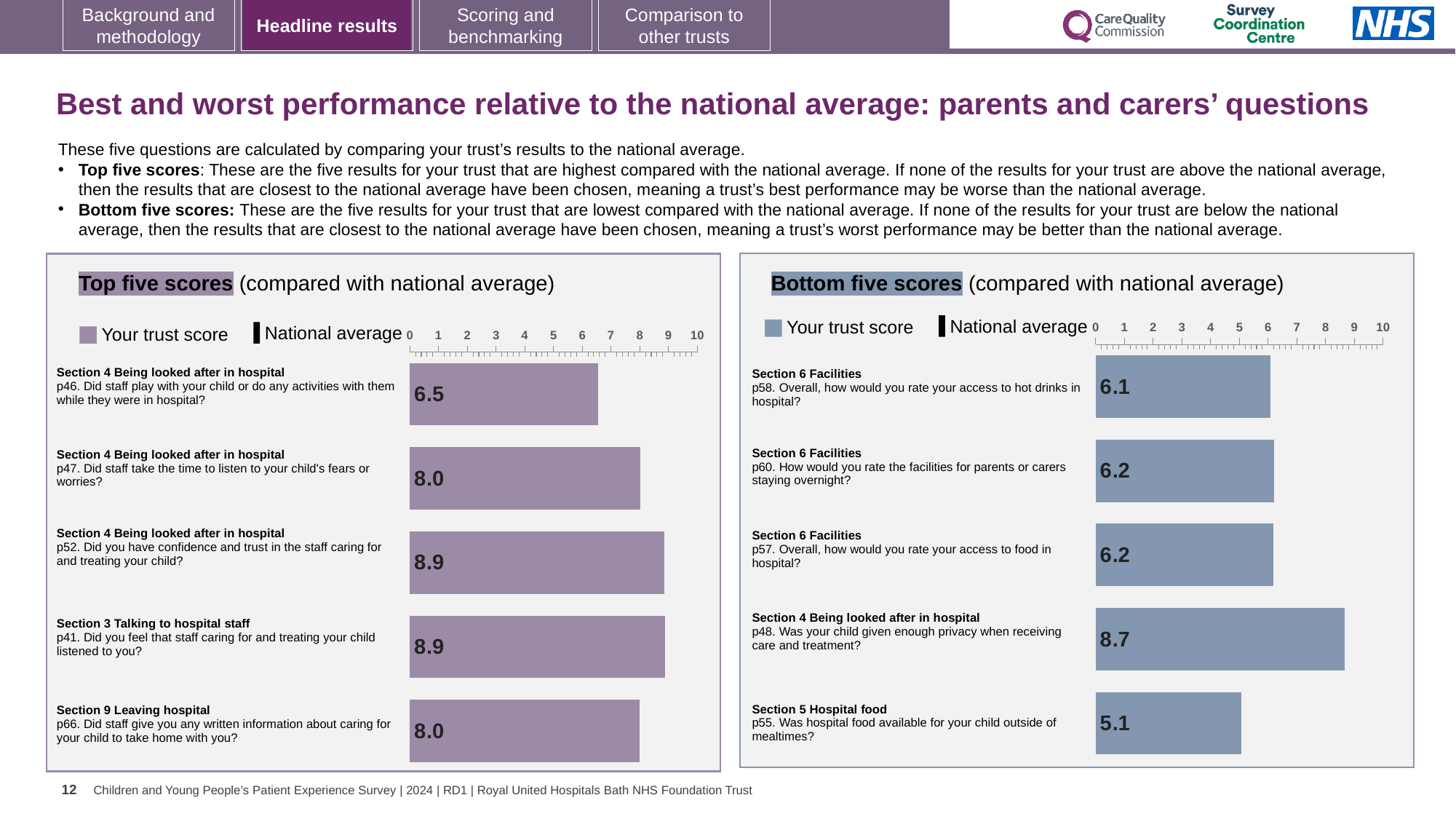
In the Bottom five scores chart, what is the trust score for p48 (Was your child given enough privacy when receiving care and treatment)? 8.7 In the Bottom five scores chart, which question has the lowest trust score? p55. Was hospital food available for your child outside of mealtimes? How many bars are shown in the Bottom five scores chart? 5 In the Top five scores chart, what is the difference between the trust score for p52 and the trust score for p46? 2.4 Which is larger: the trust score for p47 in the Top five scores chart or the trust score for p58 in the Bottom five scores chart? p47 in the Top five scores chart In the Bottom five scores chart, what is the difference between the trust score for p48 and the trust score for p55? 3.6 In the Top five scores chart, which question has the lowest trust score? p46. Did staff play with your child or do any activities with them while they were in hospital? In the Top five scores chart, what is the trust score for p52 (Did you have confidence and trust in the staff caring for and treating your child)? 8.9 In the Top five scores chart, what is the trust score for p46 (Did staff play with your child or do any activities with them while they were in hospital)? 6.5 In the Bottom five scores chart, which question has the highest trust score? p48. Was your child given enough privacy when receiving care and treatment? In the Bottom five scores chart, what is the trust score for p55 (Was hospital food available for your child outside of mealtimes)? 5.1 What type of chart is the Top five scores chart? Bar chart